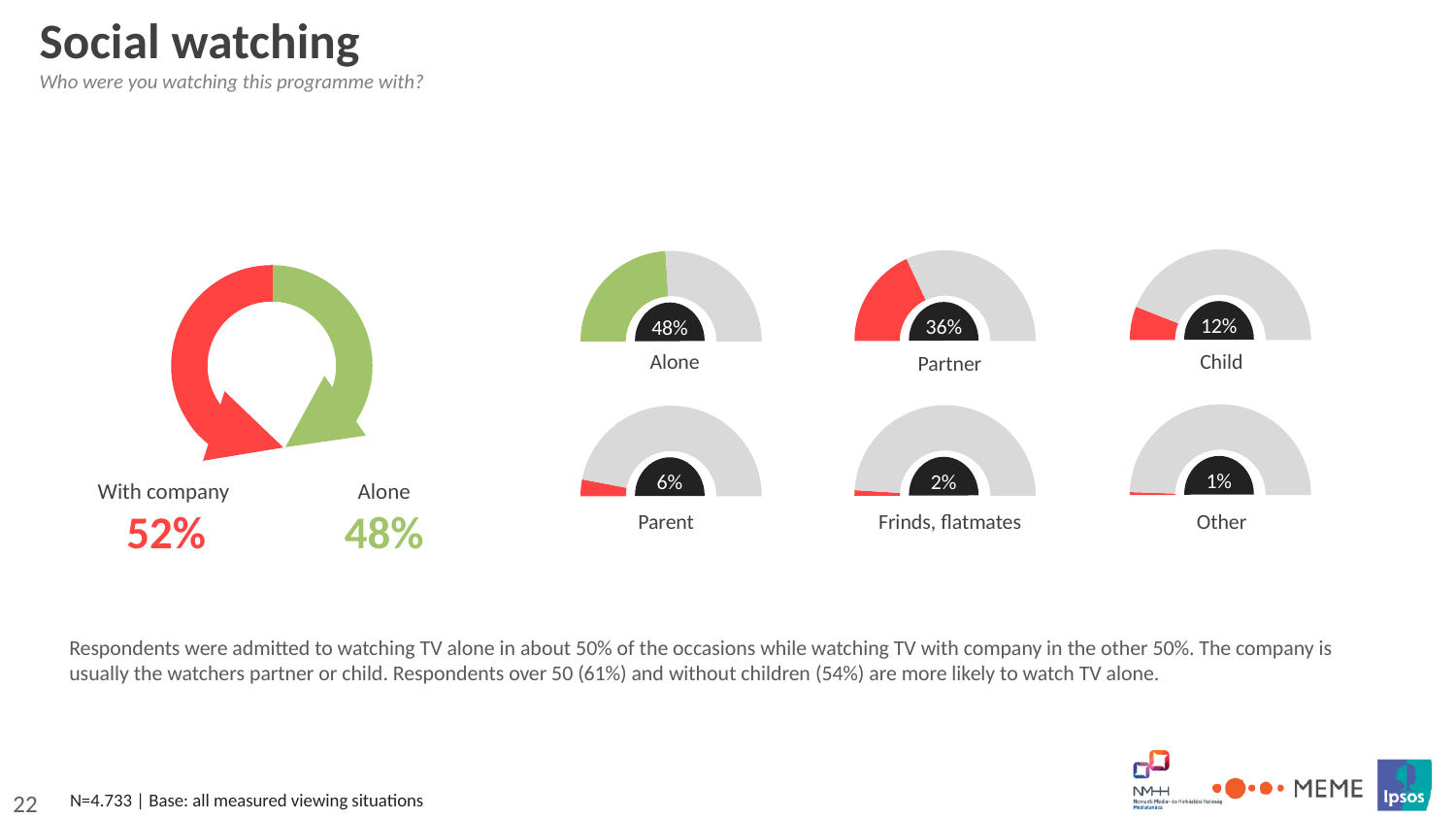
In the donut chart on the left, how many segments are shown? 2 In the gauge charts on the right, what is the value for 'Child'? 12% Among the gauge charts on the right, which category has the lowest value? Other In the gauge charts on the right, what is the value for 'Frinds, flatmates'? 2% In the donut chart on the left, what share of viewing situations were 'With company'? 52% In the donut chart on the left, what share of viewing situations were 'Alone'? 48% How many gauge charts are shown on the right side of the slide? 6 In the gauge charts on the right, what is the difference between the 'Partner' and 'Parent' values? 30% Among the gauge charts on the right, which category has the highest value? Alone In the donut chart on the left, which segment is larger, 'With company' or 'Alone'? With company In the donut chart on the left, what is the difference between the 'With company' and 'Alone' shares? 4% In the gauge charts on the right, what is the value for 'Partner'? 36%